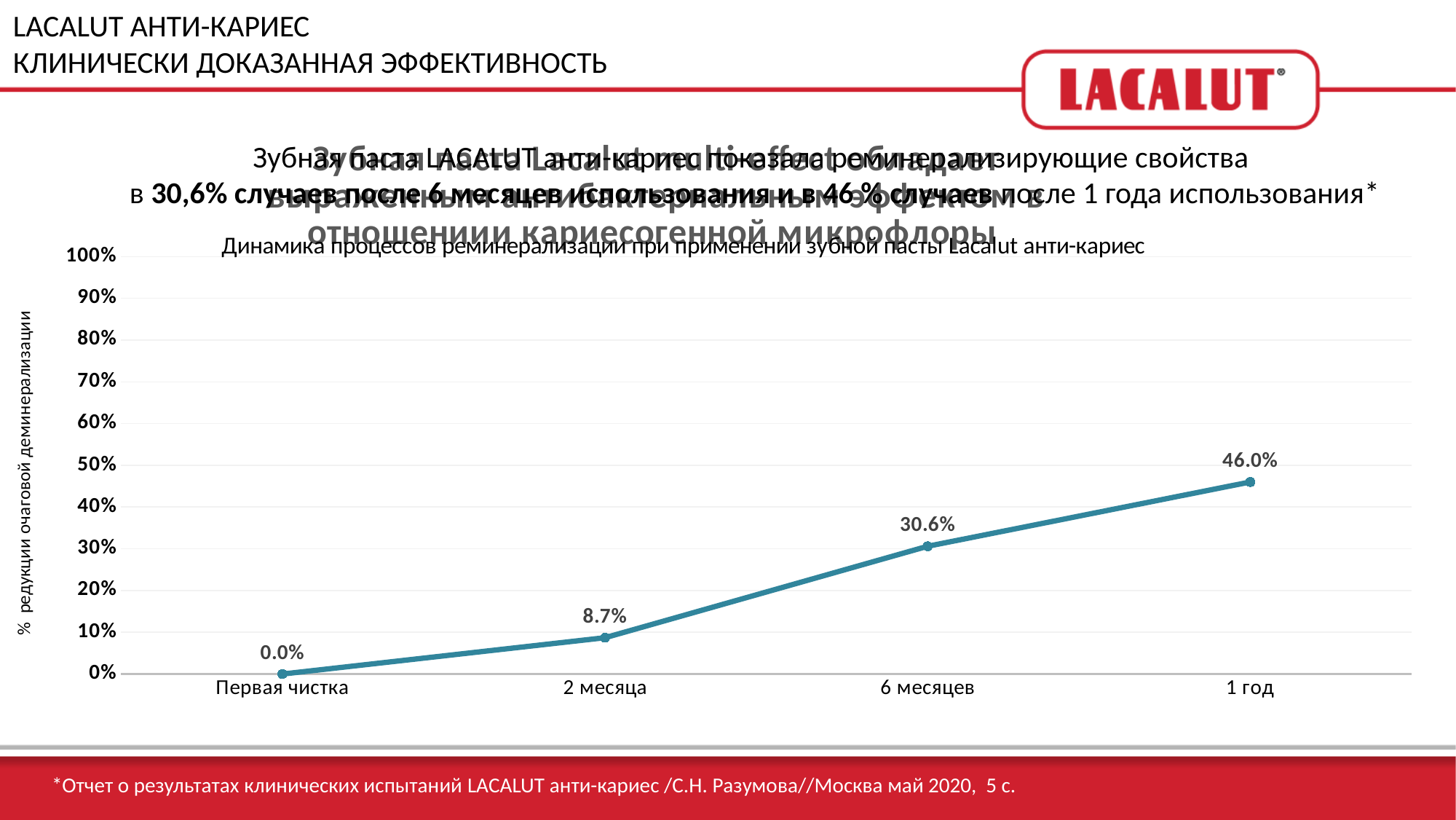
What is the difference between the values at "1 год" and "6 месяцев"? 15.4% What is the value at "2 месяца"? 8.7% Which is larger, the value at "2 месяца" or at "6 месяцев"? 6 месяцев What is the value at "1 год"? 46.0% Which time point has the lowest value? Первая чистка What type of chart is shown on the slide? line chart What is the value at "Первая чистка"? 0.0% What is the value at "6 месяцев"? 30.6% Is the value at "1 год" greater or less than 50%? less How many data points are plotted on the line? 4 Do the values rise or fall along the x axis from "Первая чистка" to "1 год"? rise Which time point has the highest value? 1 год